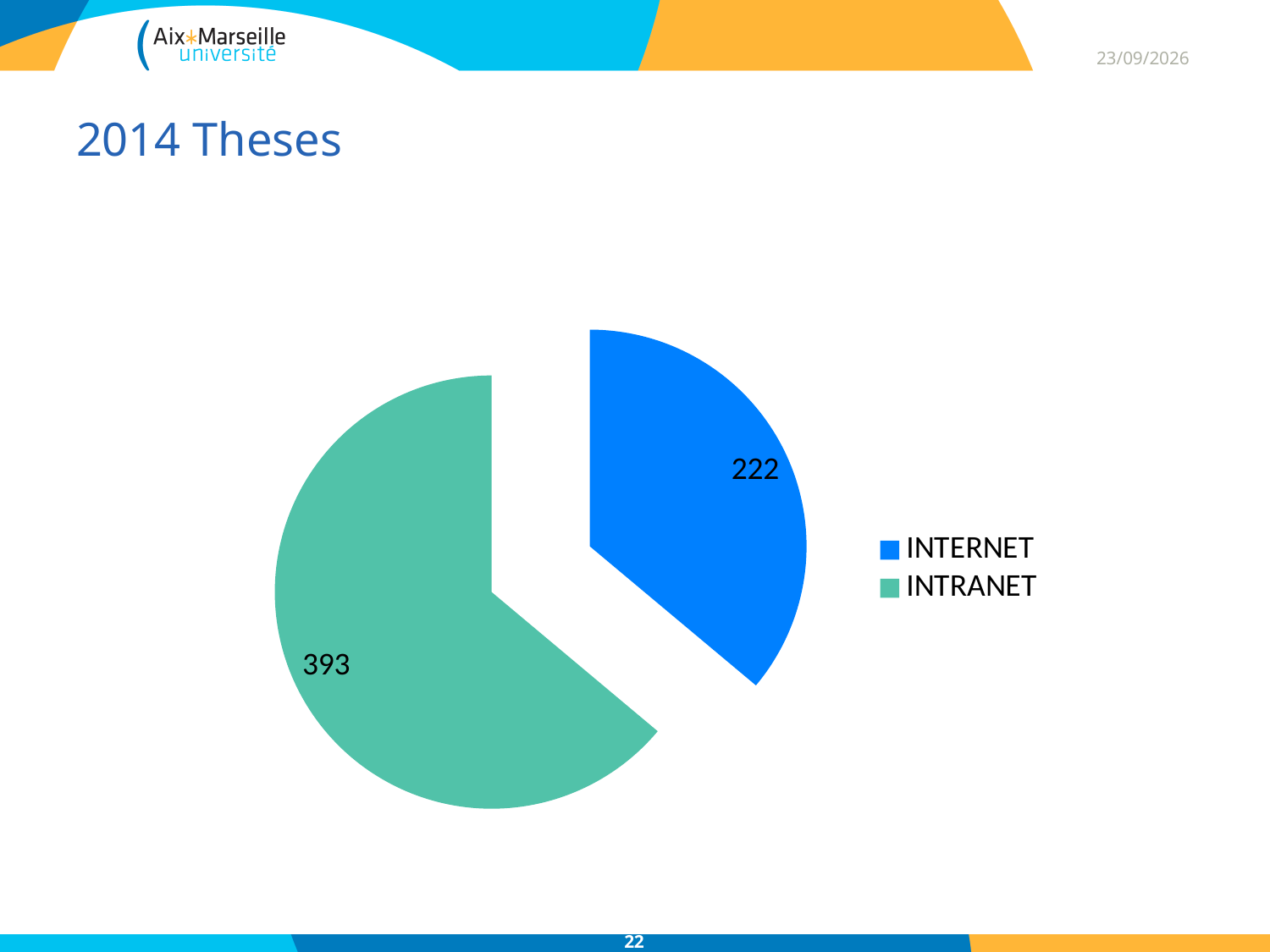
What type of chart is shown on the slide? pie chart What share of the pie does INTRANET represent, to the nearest whole percent? 64% What is the total of all slices in the pie chart? 615 What colour is the INTERNET slice? blue Which is larger, INTERNET or INTRANET? INTRANET What is the value for INTRANET? 393 What is the difference between the INTRANET and INTERNET values? 171 How many slices does the pie chart have? 2 What is the value for INTERNET? 222 How many entries does the legend list? 2 Which category has the smallest slice? INTERNET Which category has the largest slice? INTRANET